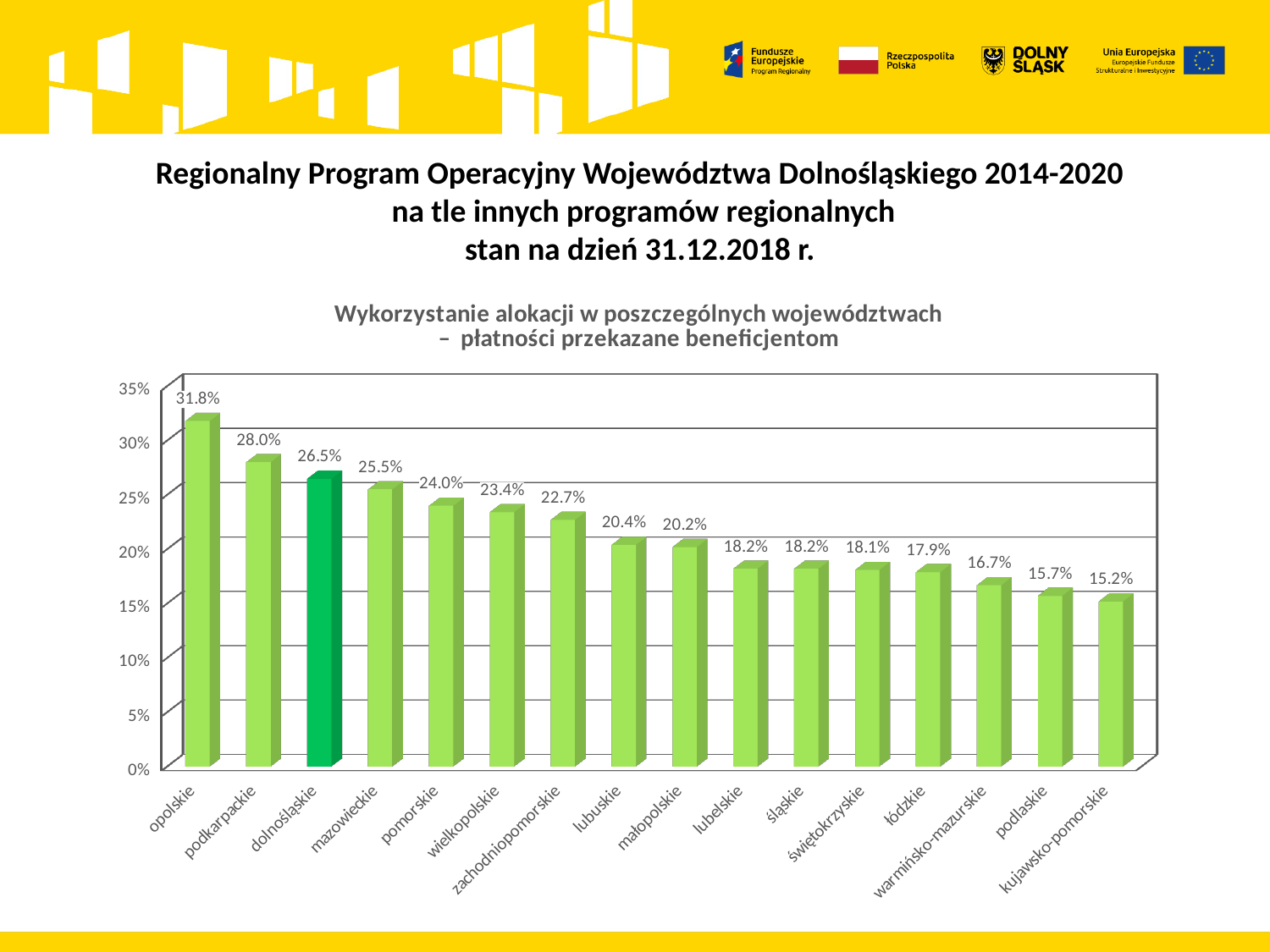
What is the difference between the values for podkarpackie and kujawsko-pomorskie? 12.8% Which has a larger value, pomorskie or lubuskie? pomorskie What kind of chart is shown on the slide? bar chart What is the value for warmińsko-mazurskie? 16.7% What is the value for opolskie? 31.8% What is the difference between the values for opolskie and dolnośląskie? 5.3% Is the value for mazowieckie greater or less than 25%? greater Which voivodeship has the highest value? opolskie How many voivodeships are shown on the chart? 16 Which bar is highlighted in a darker green colour? dolnośląskie Which voivodeship has the lowest value? kujawsko-pomorskie What is the value for dolnośląskie? 26.5%